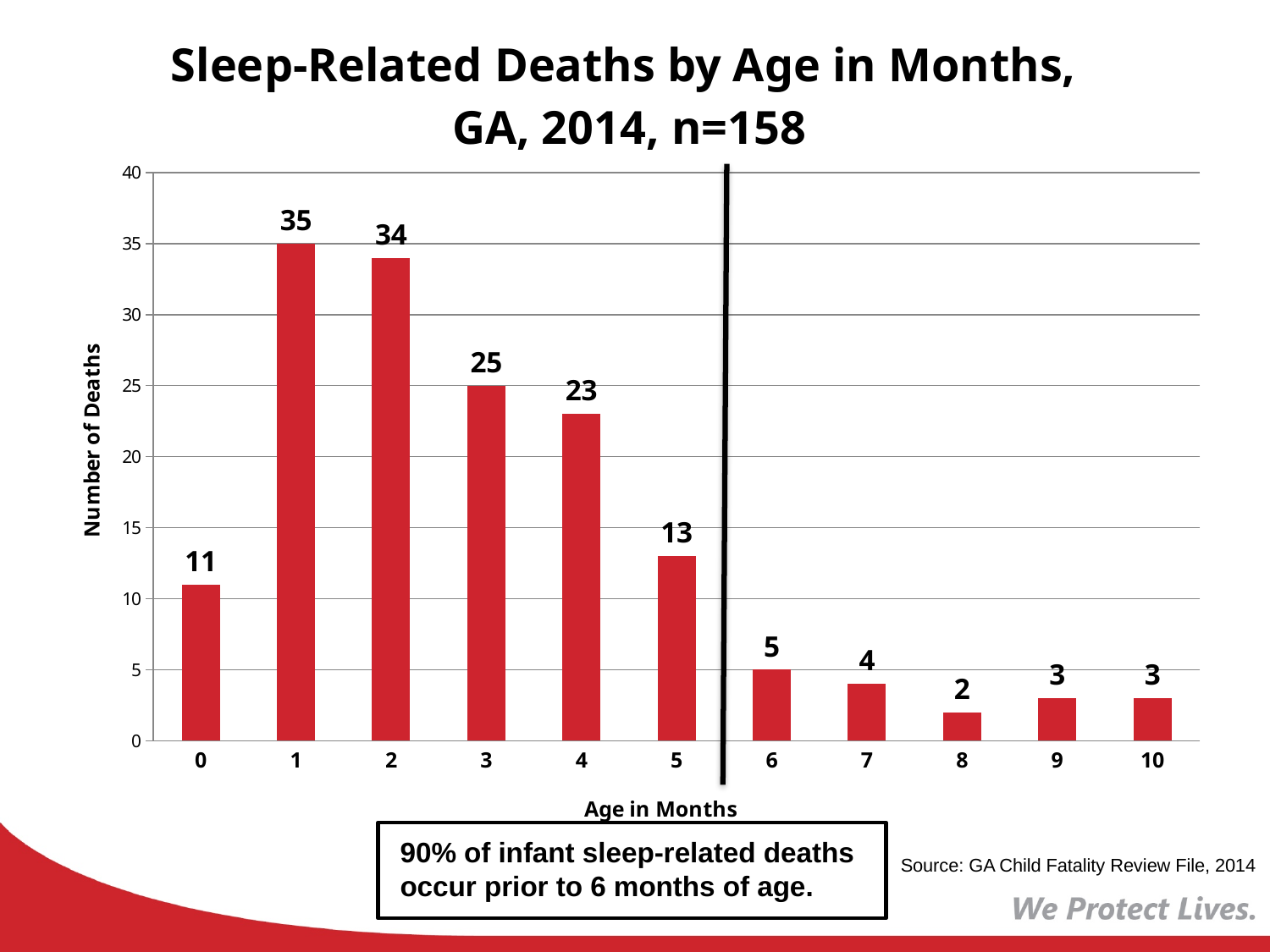
Which age in months has the highest number of deaths? 1 What is the difference in deaths between age 1 month and age 2 months? 1 How many sleep-related deaths occurred at age 1 month? 35 What is the difference in deaths between age 3 months and age 6 months? 20 Which has more deaths, age 4 months or age 5 months? 4 months How many age categories are shown on the x axis? 11 What is the number of deaths for age 0 months? 11 Is the value for age 3 months greater or less than 20? greater What is the number of deaths for age 5 months? 13 What is the title of the chart? Sleep-Related Deaths by Age in Months, GA, 2014, n=158 Which age in months has the lowest number of deaths? 8 What kind of chart is shown on the slide? Bar chart